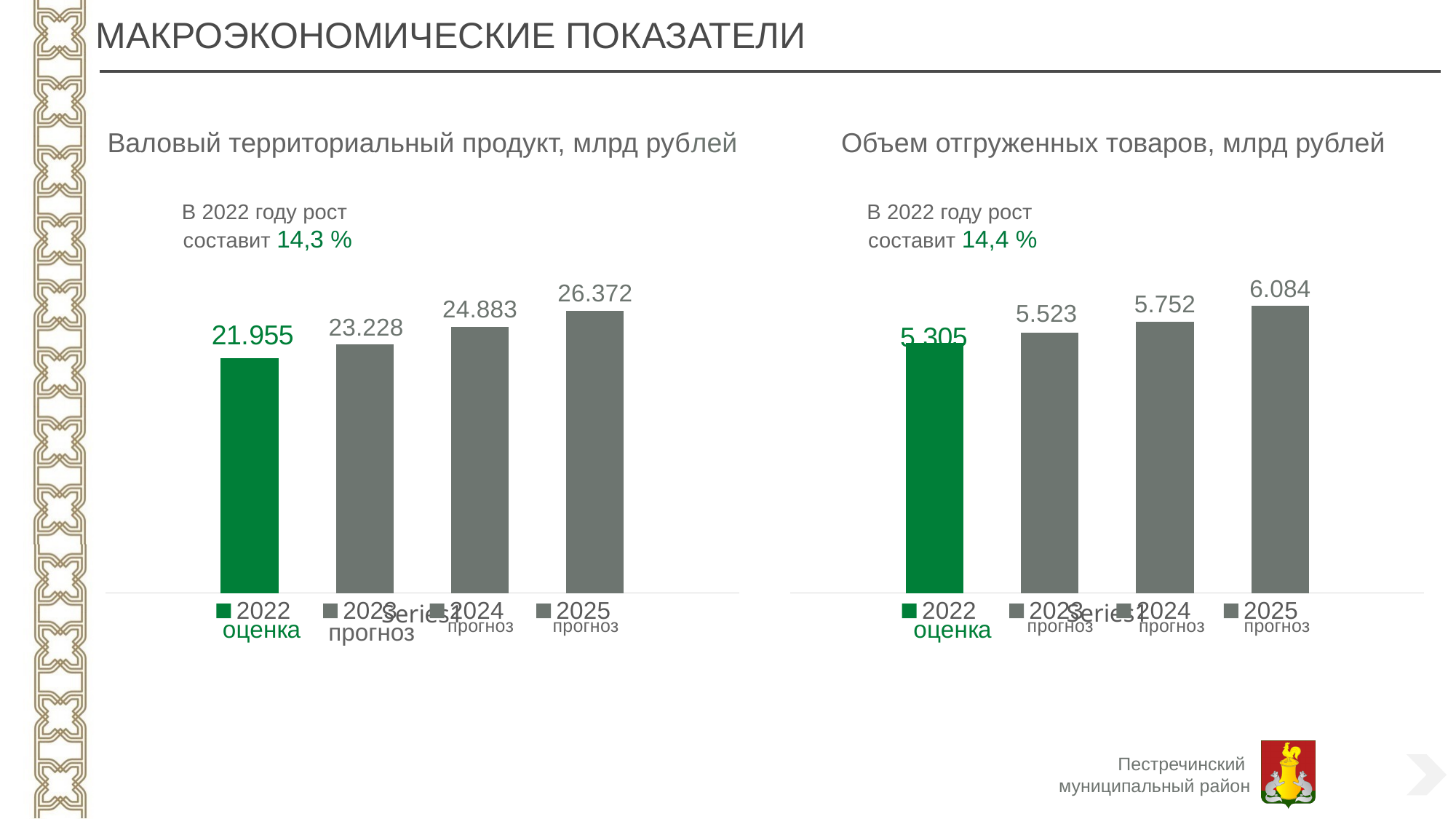
In the chart 'Объем отгруженных товаров, млрд рублей', what is the difference between the 2024 and 2023 values? 0.229 In the chart 'Объем отгруженных товаров, млрд рублей', do the values rise or fall from 2022 to 2025? Rise In the chart 'Валовый территориальный продукт, млрд рублей', what is the value for 2025? 26.372 What type of chart is 'Валовый территориальный продукт, млрд рублей'? Bar chart In the chart 'Валовый территориальный продукт, млрд рублей', which year has the highest value? 2025 How many bars are shown in the chart 'Объем отгруженных товаров, млрд рублей'? 4 In the chart 'Валовый территориальный продукт, млрд рублей', which is larger: the value for 2023 or the value for 2024? 2024 In the chart 'Валовый территориальный продукт, млрд рублей', what is the value for 2022? 21.955 In the chart 'Объем отгруженных товаров, млрд рублей', which year has the lowest value? 2022 In the chart 'Объем отгруженных товаров, млрд рублей', what is the value for 2025? 6.084 In the chart 'Объем отгруженных товаров, млрд рублей', what is the value for 2023? 5.523 In the chart 'Валовый территориальный продукт, млрд рублей', what is the difference between the 2025 and 2022 values? 4.417